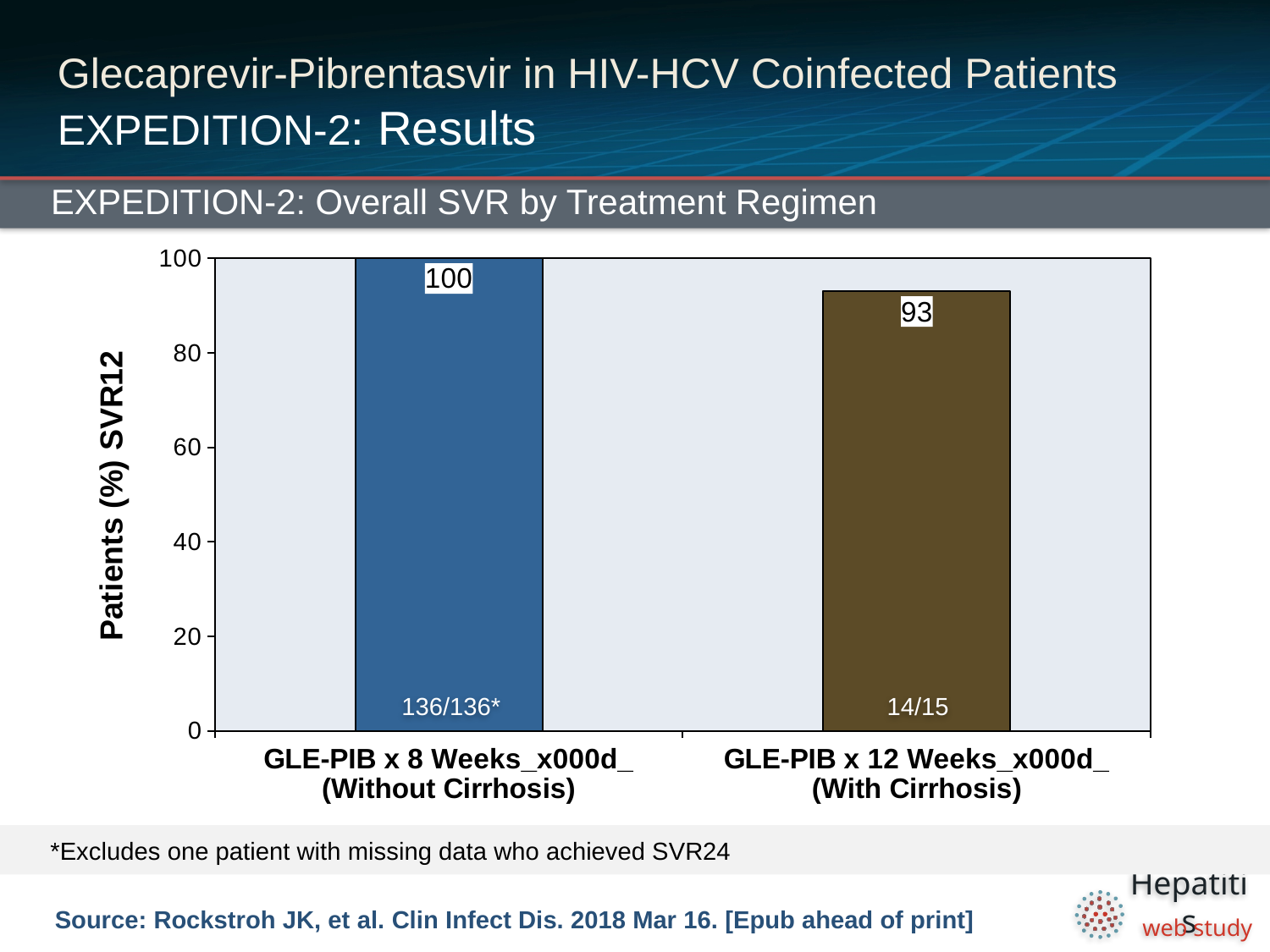
What is the SVR12 value for GLE-PIB x 8 Weeks (Without Cirrhosis)? 100 What is the label of the y-axis? Patients (%) SVR12 What kind of chart is shown on the slide? Bar chart What patient fraction is shown on the bar for GLE-PIB x 8 Weeks (Without Cirrhosis)? 136/136* Is the SVR12 value for GLE-PIB x 12 Weeks (With Cirrhosis) greater or less than 80? greater How many treatment regimens are shown in the chart? 2 Which treatment regimen has the highest SVR12 percentage? GLE-PIB x 8 Weeks (Without Cirrhosis) What patient fraction is shown on the bar for GLE-PIB x 12 Weeks (With Cirrhosis)? 14/15 Which treatment regimen has the lowest SVR12 percentage? GLE-PIB x 12 Weeks (With Cirrhosis) What is the SVR12 value for GLE-PIB x 12 Weeks (With Cirrhosis)? 93 What is the difference in SVR12 percentage between the 8-week and 12-week regimens? 7 Which is larger, the SVR12 value for the 8-week regimen or the 12-week regimen? GLE-PIB x 8 Weeks (Without Cirrhosis)